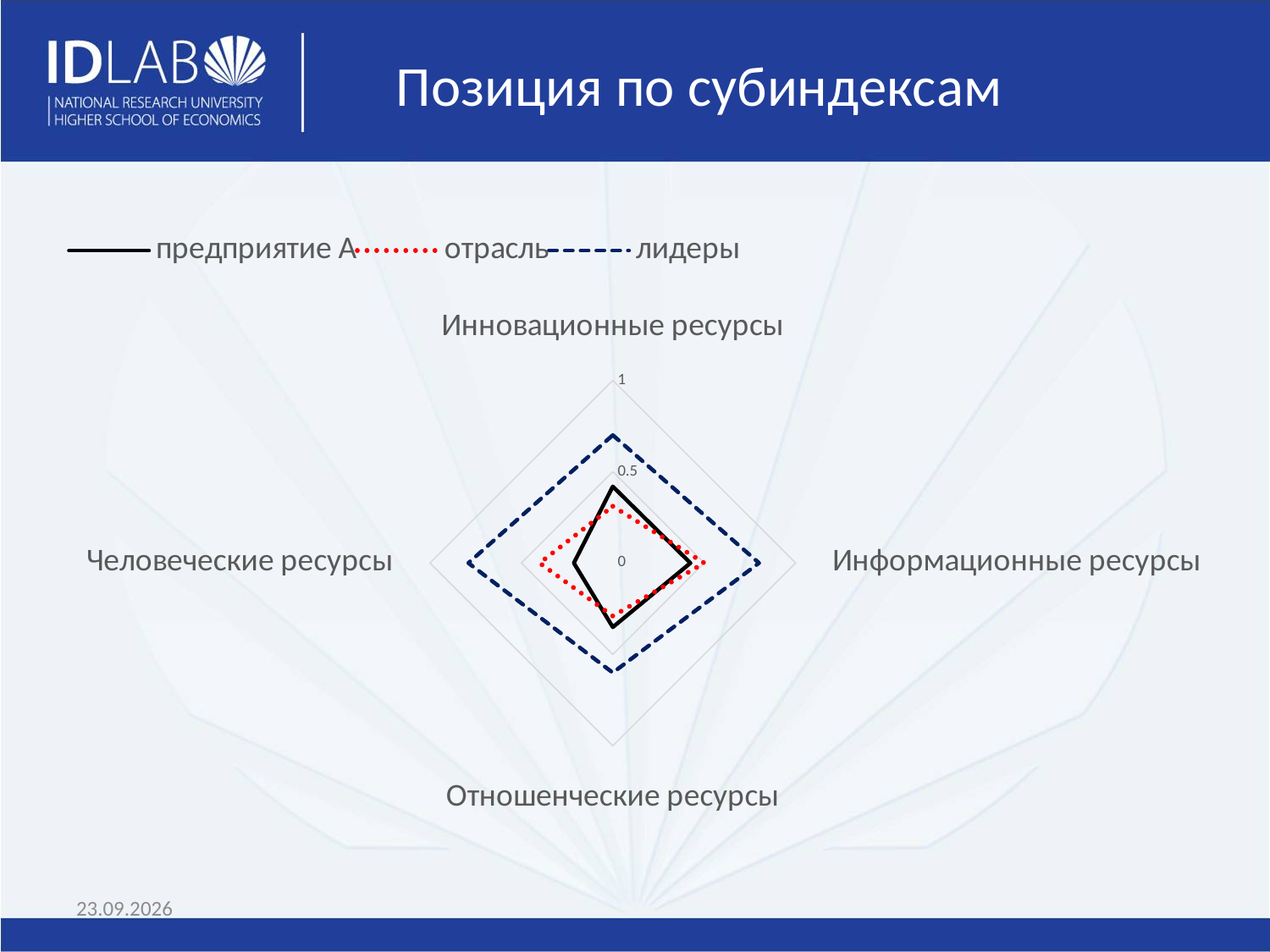
Is the value of лидеры for Инновационные ресурсы greater or less than 0.5? greater Is the value of предприятие А for Человеческие ресурсы greater or less than 0.5? less Is the value of отрасль for Отношенческие ресурсы greater or less than 0.5? less What kind of chart is shown on the slide? radar chart How many axes (categories) does the radar chart have? 4 Which series is drawn with a red dotted line? отрасль How many series does the legend list? 3 Which series has the highest value for Информационные ресурсы? лидеры Which series has the larger value for Инновационные ресурсы, лидеры or предприятие А? лидеры